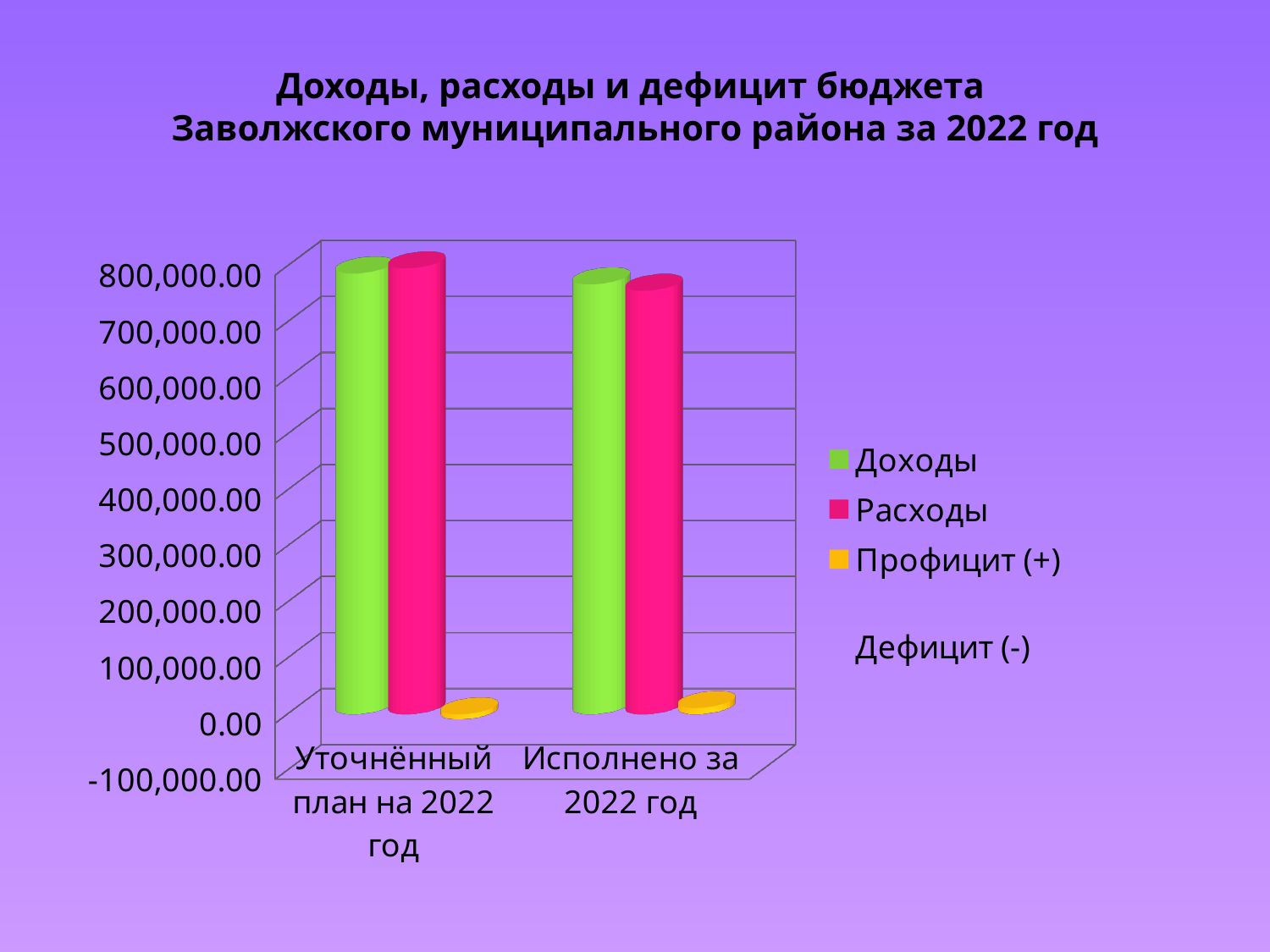
Is the value of Расходы for Исполнено за 2022 год greater or less than 600,000.00? greater How many series does the legend list? 3 Which is larger: Расходы for Уточнённый план на 2022 год or Расходы for Исполнено за 2022 год? Уточнённый план на 2022 год Is the value of Профицит (+) Дефицит (-) for Исполнено за 2022 год greater or less than 100,000.00? less What kind of chart is shown on the slide? Bar chart How many categories are shown on the x axis? 2 What is the title of the chart? Доходы, расходы и дефицит бюджета Заволжского муниципального района за 2022 год Is the value of Доходы for Уточнённый план на 2022 год greater or less than 700,000.00? greater Which is larger: Доходы for Уточнённый план на 2022 год or Доходы for Исполнено за 2022 год? Уточнённый план на 2022 год Do the Доходы values rise or fall from Уточнённый план на 2022 год to Исполнено за 2022 год? fall Which colour represents the Доходы series? Green Which series has the lowest value for Исполнено за 2022 год? Профицит (+) Дефицит (-)